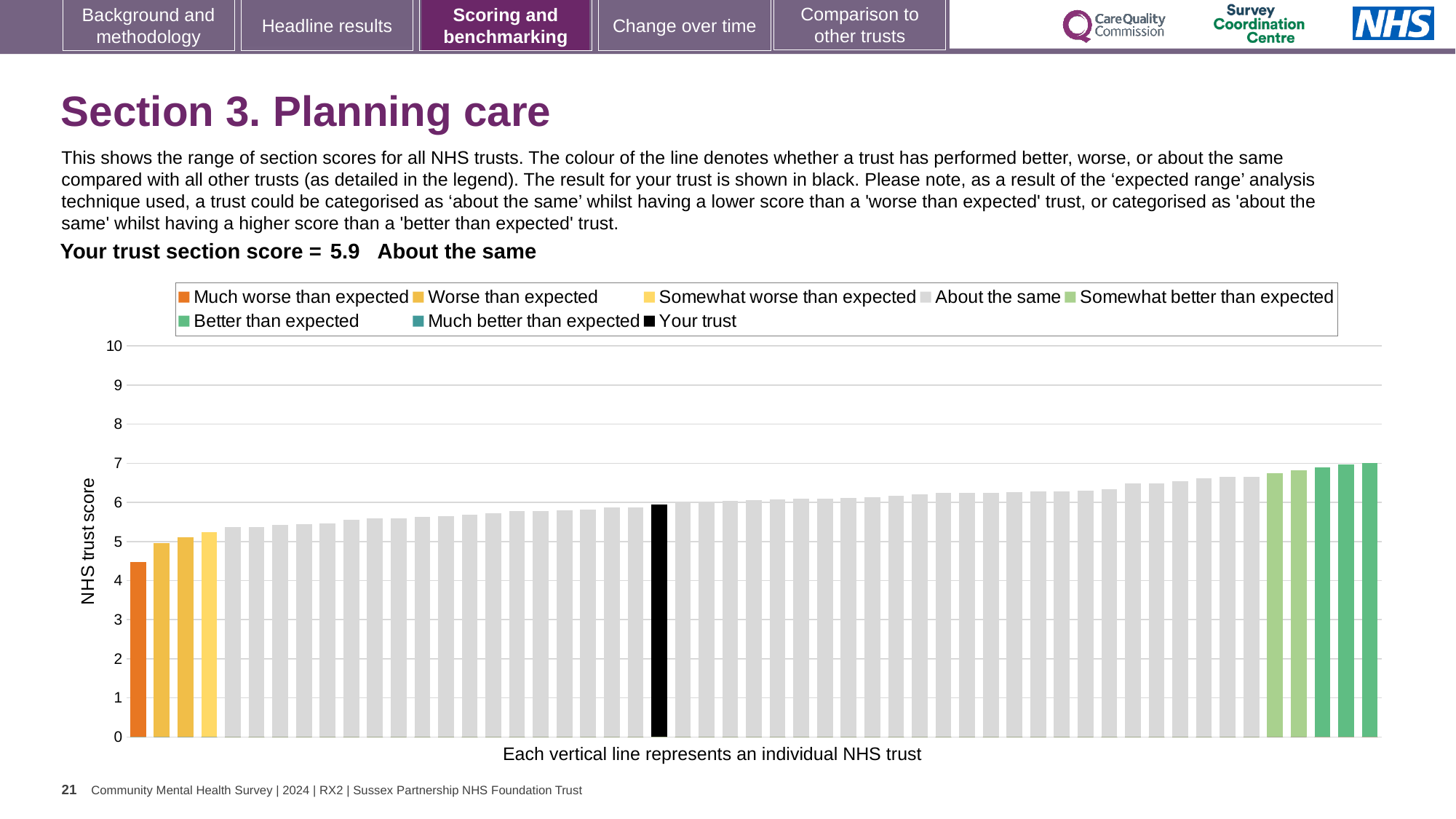
What is the section score for your trust shown on the slide? 5.9 What kind of chart is shown on the slide? bar chart Which legend category does the highest bar on the chart belong to? Better than expected How many entries does the chart legend list? 8 Is the value of the rightmost bar greater or less than 6? greater How many bars are coloured as 'Much worse than expected' (orange)? 1 What is the label on the vertical axis of the chart? NHS trust score Which legend category does the lowest bar on the chart belong to? Much worse than expected How is your trust's section score categorised compared with other trusts? About the same Do the bar values rise or fall from left to right along the x axis? rise Is the value of the leftmost (orange) bar greater or less than 5? less Is the value of the black 'Your trust' bar greater or less than 5? greater